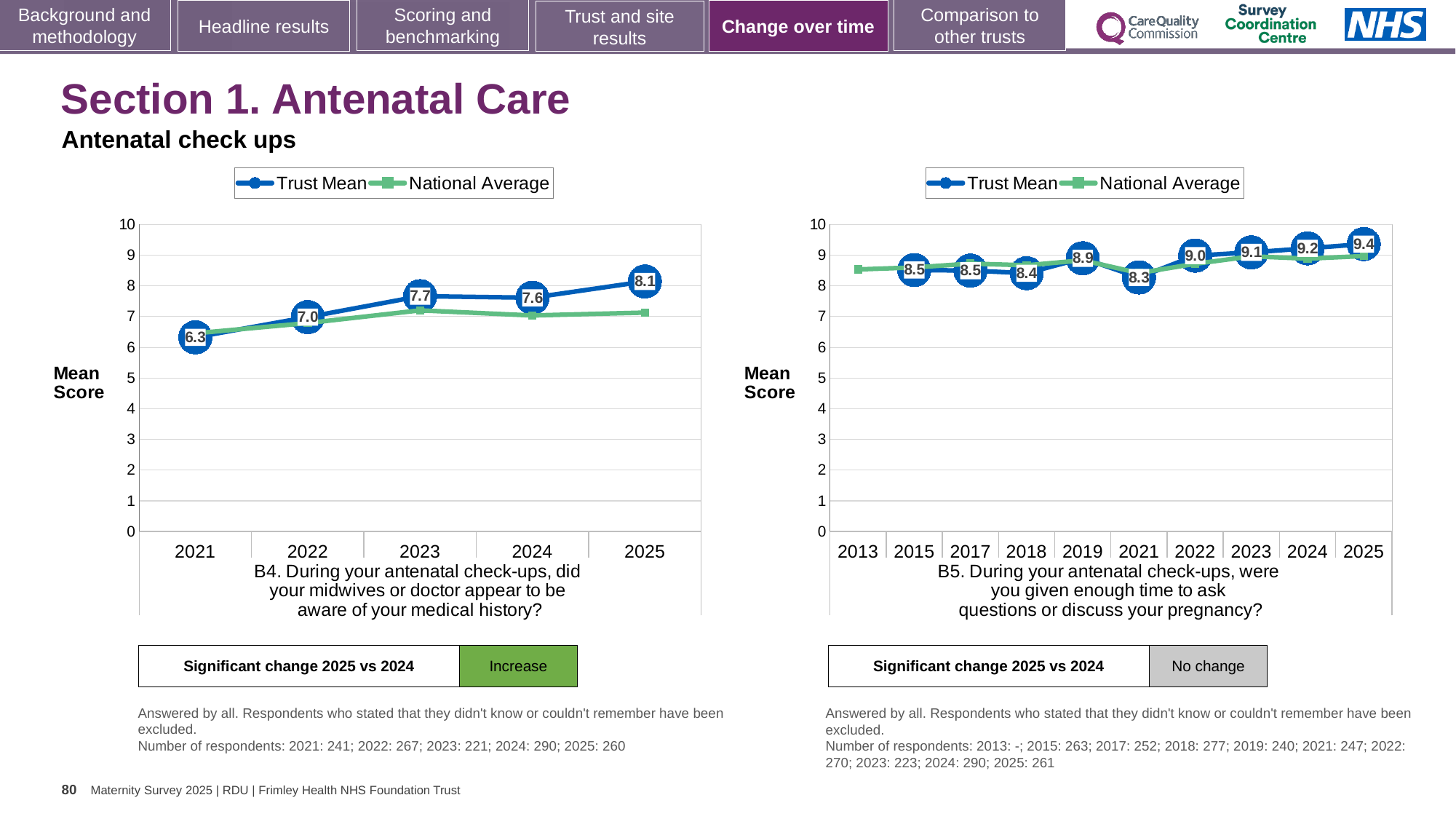
In the left chart (B4), what is the Trust Mean score for 2025? 8.1 In the right chart (B5), what is the Trust Mean score for 2021? 8.3 In the right chart (B5), what is the Trust Mean score for 2025? 9.4 In the right chart (B5), how many series does the legend list? 2 In the left chart (B4), what is the Trust Mean score for 2021? 6.3 What type of chart is the left chart (B4)? Line chart In the right chart (B5), what is the difference between the Trust Mean scores for 2025 and 2024? 0.2 In the left chart (B4), which year has the lowest Trust Mean score? 2021 In the right chart (B5), which year has the highest Trust Mean score? 2025 In the left chart (B4), how many years are shown on the x axis? 5 In the left chart (B4), what is the difference between the Trust Mean scores for 2025 and 2021? 1.8 In the left chart (B4), is the Trust Mean for 2023 or 2024 higher? 2023